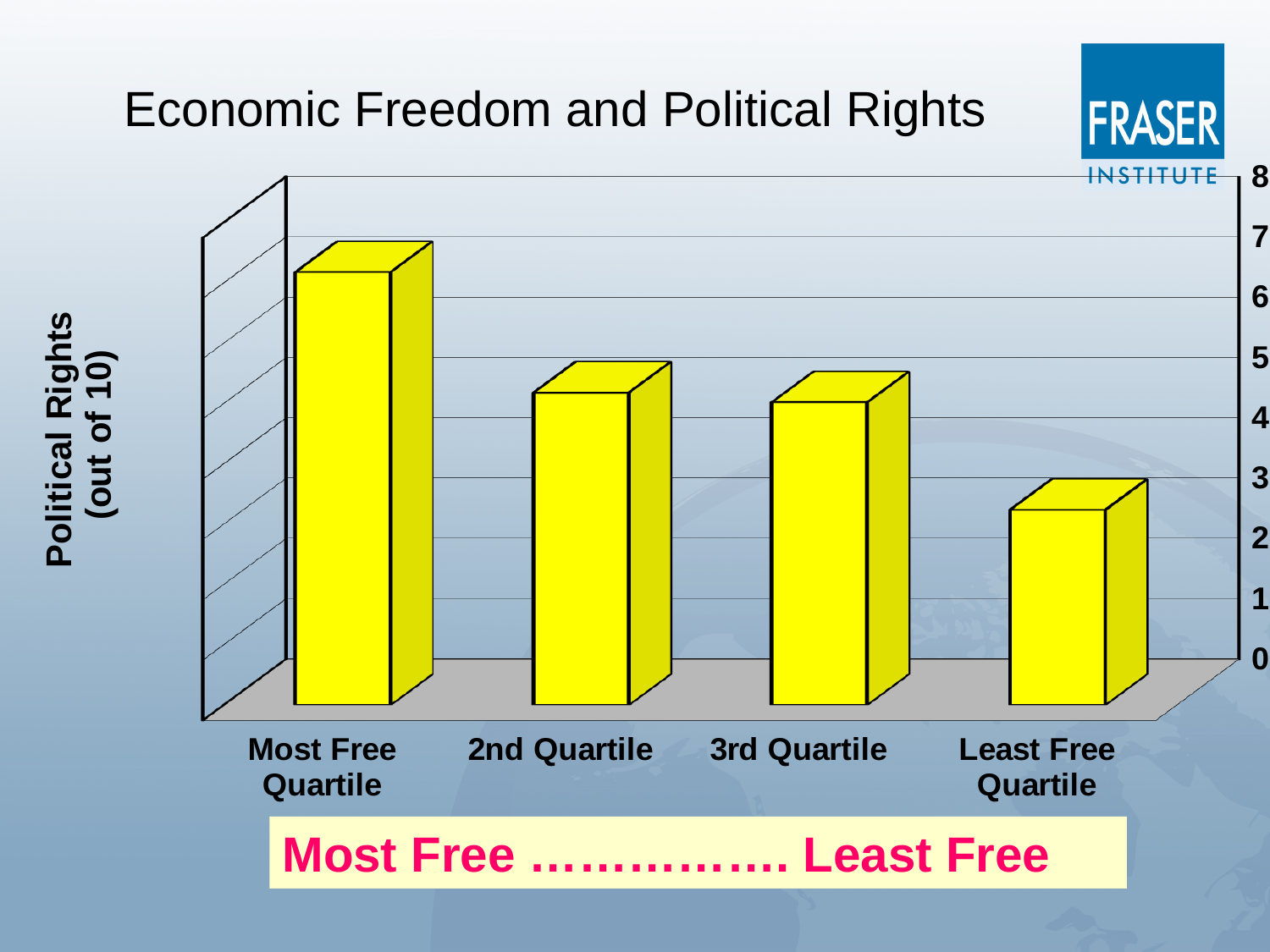
Do the values rise or fall moving from the Most Free Quartile to the Least Free Quartile? fall How many categories are plotted on the chart? 4 What kind of chart is shown on the slide? bar chart Is the value for the Most Free Quartile greater or less than 6? greater Which has a larger value, the Most Free Quartile or the Least Free Quartile? Most Free Quartile Is the value for the 3rd Quartile greater or less than 4? greater Which category has the lowest political rights value? Least Free Quartile What is the label on the vertical axis of the chart? Political Rights (out of 10) Which category has the highest political rights value? Most Free Quartile